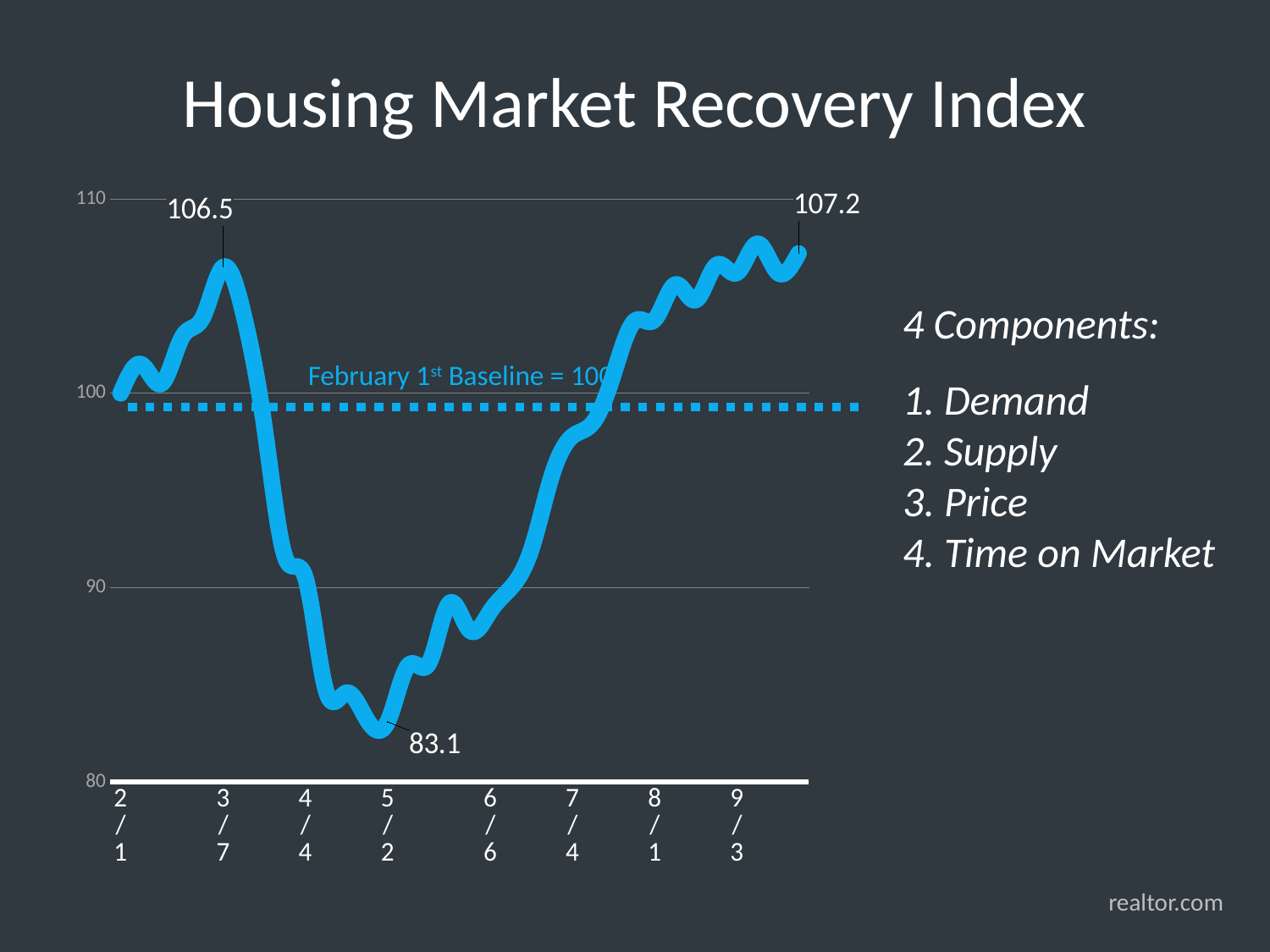
What is the lowest labeled value on the line? 83.1 Which labeled value is larger, the one near 3/7 or the one at the end of the line? the one at the end of the line (107.2) Is the value at 5/2 greater or less than 90? less What is the title of the chart? Housing Market Recovery Index What kind of chart is shown on the slide? line chart What is the difference between the labeled values 106.5 and 83.1? 23.4 How many date labels are shown on the x axis? 8 What is the highest labeled value on the line? 107.2 What value is labeled at the peak near 3/7? 106.5 What is the difference between the labeled values 107.2 and 83.1? 24.1 Is the value at 8/1 greater or less than 100? greater What value does the dashed baseline represent according to the chart label? 100